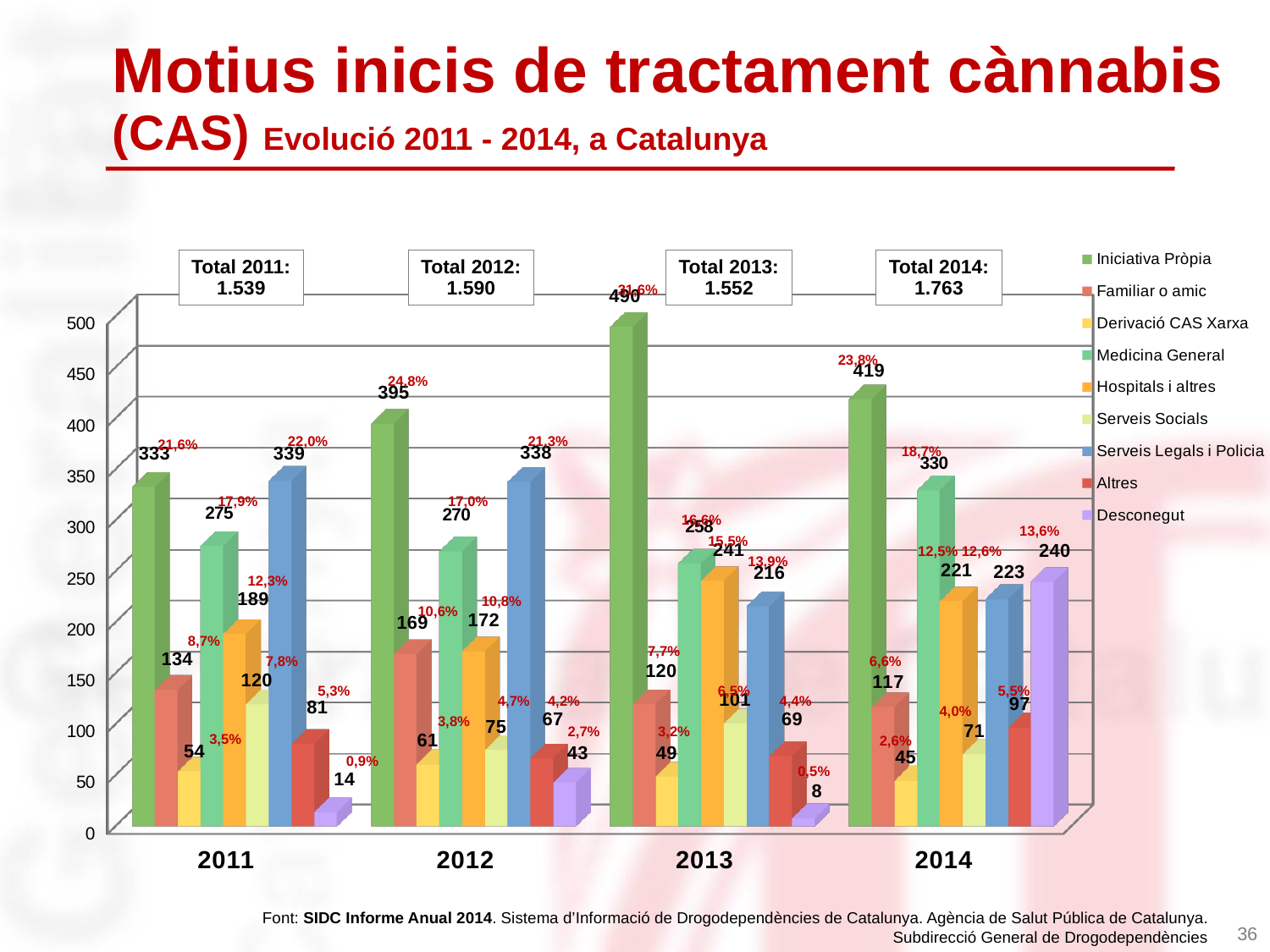
What is the difference between the Serveis Legals i Policia values for 2011 and 2013? 123 What kind of chart is shown on the slide? bar chart In 2012, which is larger: Medicina General or Hospitals i altres? Medicina General What is the value for Iniciativa Pròpia in 2013? 490 What is the value for Hospitals i altres in 2014? 221 How many years are shown on the x axis? 4 In which year is the value for Iniciativa Pròpia highest? 2013 What is the difference between the Iniciativa Pròpia values for 2014 and 2011? 86 What is the value for Desconegut in 2011? 14 Which category has the lowest value in 2013? Desconegut What percentage is shown for Serveis Legals i Policia in 2011? 22,0% How many series does the legend list? 9